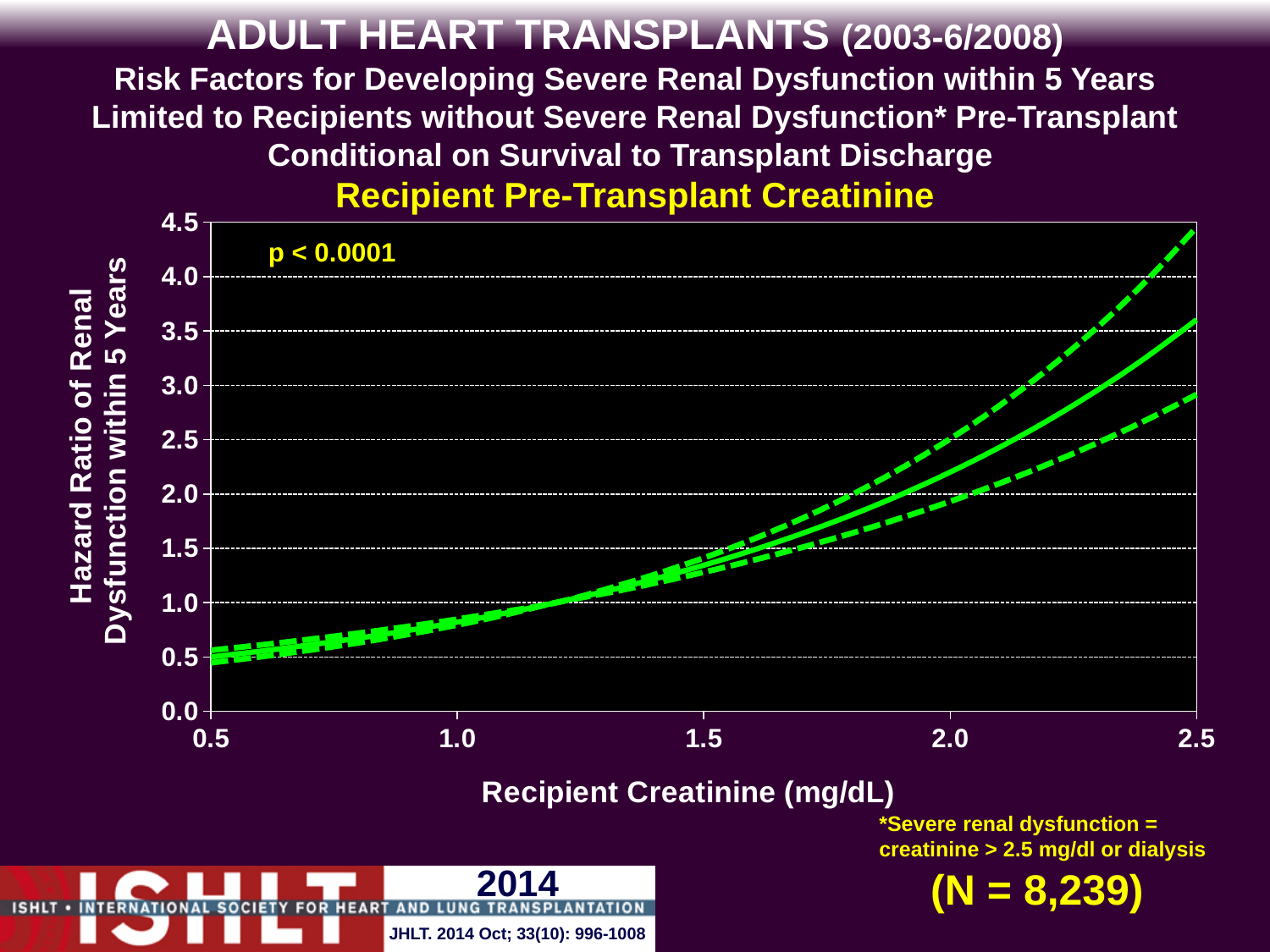
Is the lower dashed line at a recipient creatinine of 2.5 mg/dL greater or less than 2.5? greater How many lines (curves) are plotted on the chart? 3 Is the upper dashed line at a recipient creatinine of 2.5 mg/dL greater or less than 4.0? greater What kind of chart is shown on the slide? line chart Does the hazard ratio rise or fall as recipient creatinine increases from 0.5 to 2.5 mg/dL? rise Is the hazard ratio on the solid line higher at a recipient creatinine of 2.5 mg/dL or at 1.5 mg/dL? 2.5 mg/dL What p-value is printed on the chart? p < 0.0001 Is the hazard ratio on the solid line at a recipient creatinine of 0.5 mg/dL greater or less than 1.0? less What is the label of the x axis? Recipient Creatinine (mg/dL)